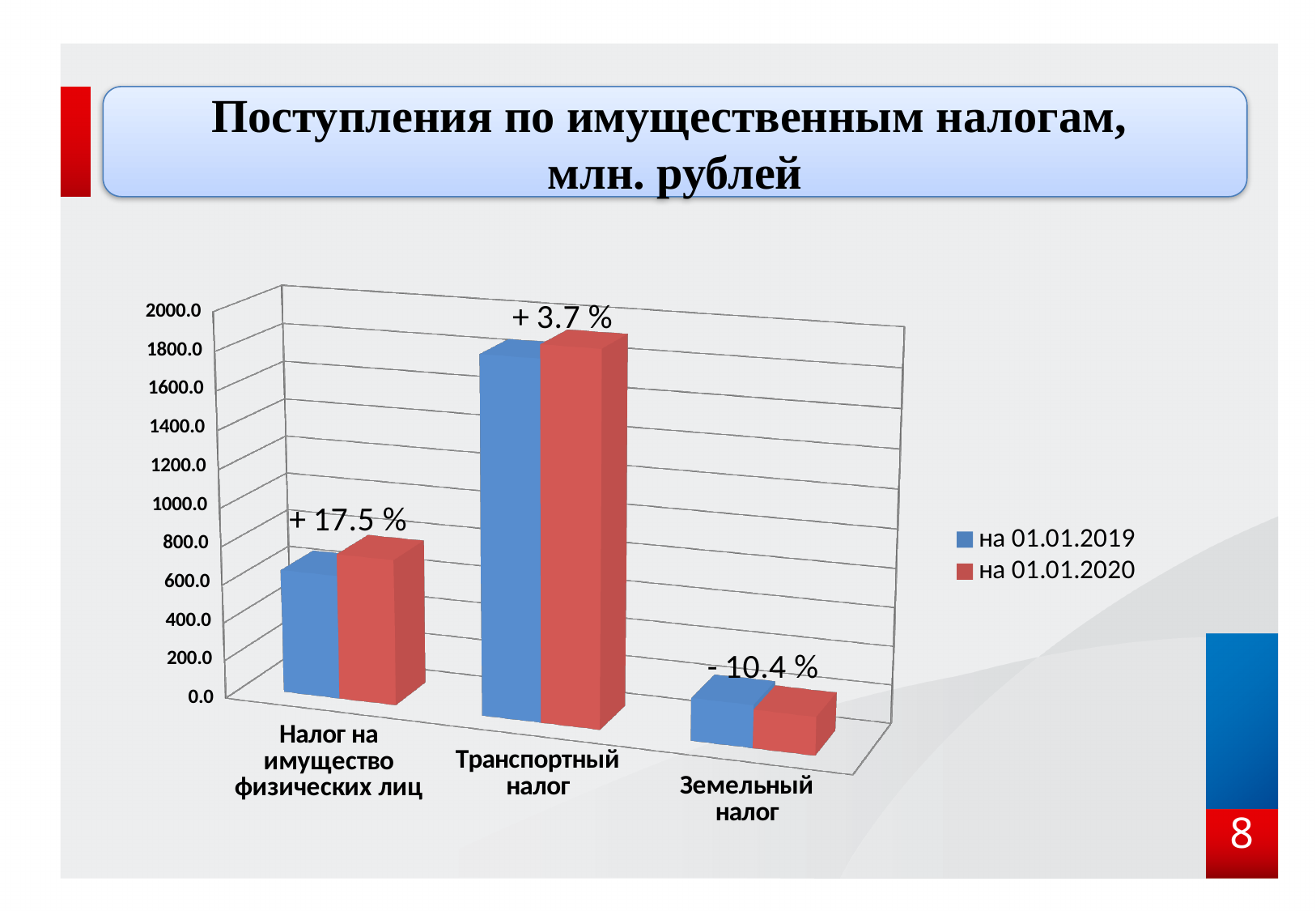
For Земельный налог, which is larger: the value на 01.01.2019 or на 01.01.2020? на 01.01.2019 What percentage change is printed above the bars for Земельный налог? - 10.4 % For Налог на имущество физических лиц, which is larger: the value на 01.01.2019 or на 01.01.2020? на 01.01.2020 Which tax category has the lowest values in the chart? Земельный налог What percentage change is printed above the bars for Налог на имущество физических лиц? + 17.5 % Which tax category has the highest values in the chart? Транспортный налог How many series does the chart legend list? 2 What percentage change is printed above the bars for Транспортный налог? + 3.7 % What is the title of the chart on the slide? Поступления по имущественным налогам, млн. рублей How many tax categories are shown on the x axis of the chart? 3 What kind of chart is shown on the slide? bar chart Is the value for Транспортный налог на 01.01.2019 greater or less than 1400.0? greater